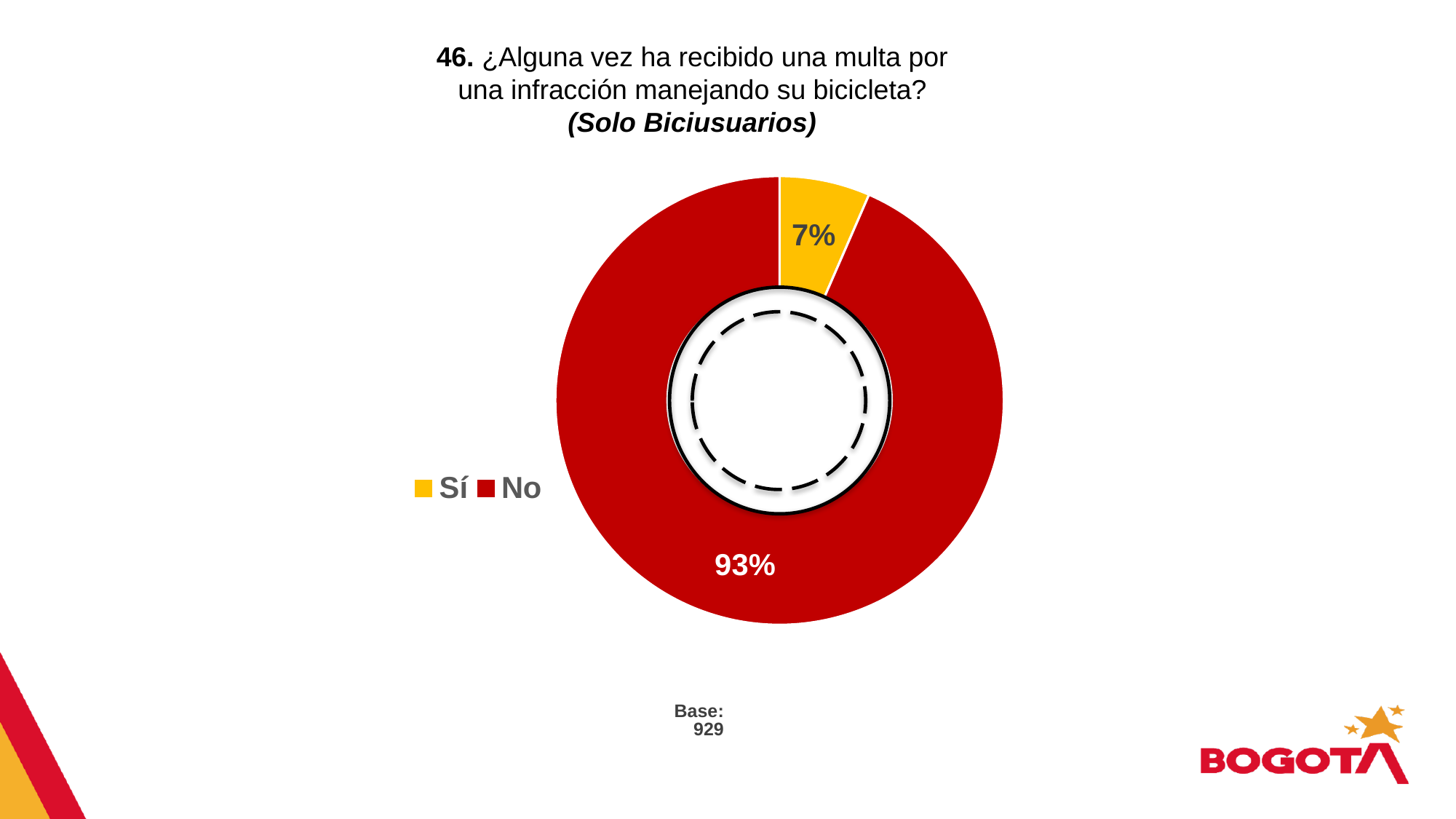
How many categories does the chart show? 2 What share of the pie does the "Sí" slice represent? 7% What percentage of respondents answered "Sí"? 7% Which response has the largest share of the chart? No What is the base (number of respondents) shown below the chart? 929 Which response has the smallest share of the chart? Sí How many entries does the legend list? 2 Which response is larger, "Sí" or "No"? No What percentage of respondents answered "No"? 93% What kind of chart is shown on the slide? Pie chart (doughnut) What is the difference in percentage points between the "No" and "Sí" responses? 86 What colour represents the "No" response in the chart? Red